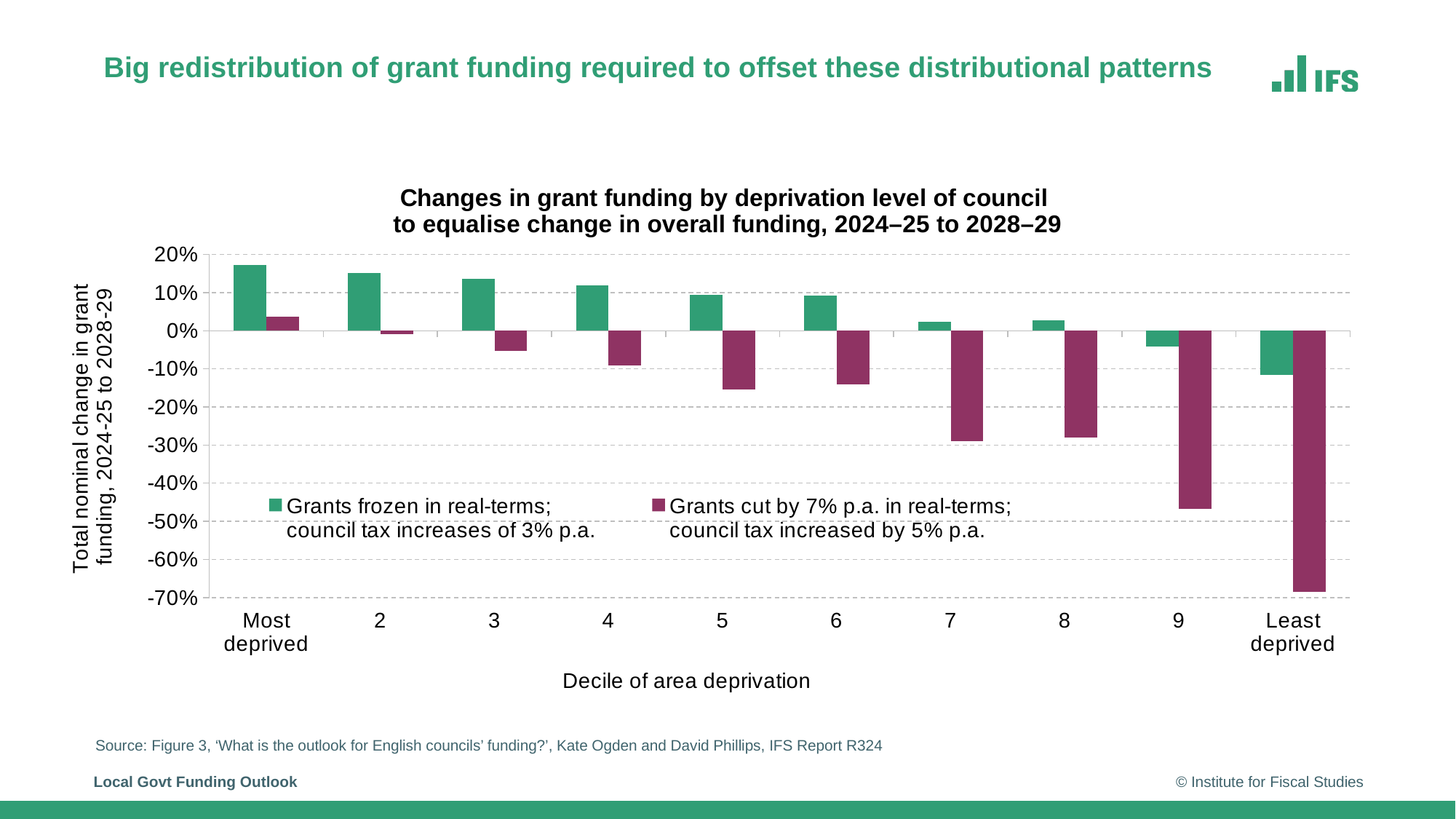
For the 'Grants cut by 7% p.a. in real-terms; council tax increased by 5% p.a.' series, which decile has the lowest value? Least deprived What colour represents the 'Grants cut by 7% p.a. in real-terms; council tax increased by 5% p.a.' series? Purple Is the value for the Most deprived decile in the 'Grants frozen in real-terms' series greater or less than 10%? greater What kind of chart is shown on the slide? Bar chart How many deciles of area deprivation are shown on the x axis? 10 In the 'Grants frozen in real-terms' series, which is larger: the value for the Most deprived decile or the value for decile 4? Most deprived Do the values for the 'Grants cut by 7% p.a. in real-terms' series generally rise or fall moving from the Most deprived to the Least deprived decile? fall Is the value for the Least deprived decile in the 'Grants cut by 7% p.a. in real-terms' series greater or less than -60%? less For the 'Grants frozen in real-terms; council tax increases of 3% p.a.' series, which decile has the highest value? Most deprived Is the value for decile 9 in the 'Grants cut by 7% p.a. in real-terms' series greater or less than -40%? less How many series does the legend list? 2 What is the title of the x axis? Decile of area deprivation